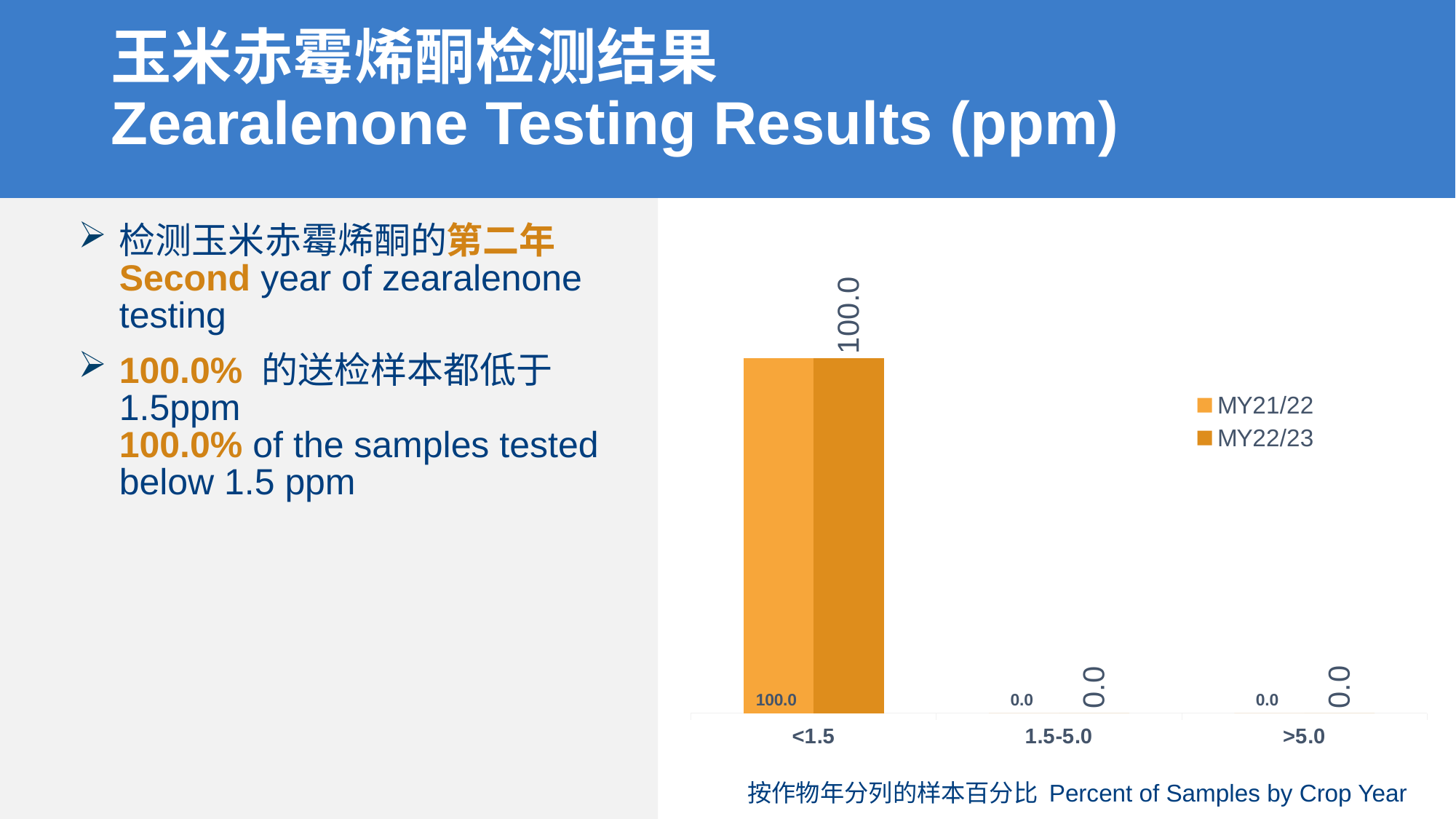
What is the value for MY22/23 in the >5.0 category? 0.0 Do the values for MY22/23 rise or fall from <1.5 to >5.0? fall What is the value for MY22/23 in the <1.5 category? 100.0 What kind of chart is shown on the slide? bar chart What are the two series named in the legend? MY21/22 and MY22/23 What is the value for MY21/22 in the <1.5 category? 100.0 How many series does the legend list? 2 What is the value for MY21/22 in the 1.5-5.0 category? 0.0 How many categories are shown on the x axis? 3 What is the difference between the MY21/22 values for <1.5 and 1.5-5.0? 100.0 Which is larger for MY21/22: the value for <1.5 or the value for >5.0? <1.5 Which category has the highest value for MY22/23? <1.5